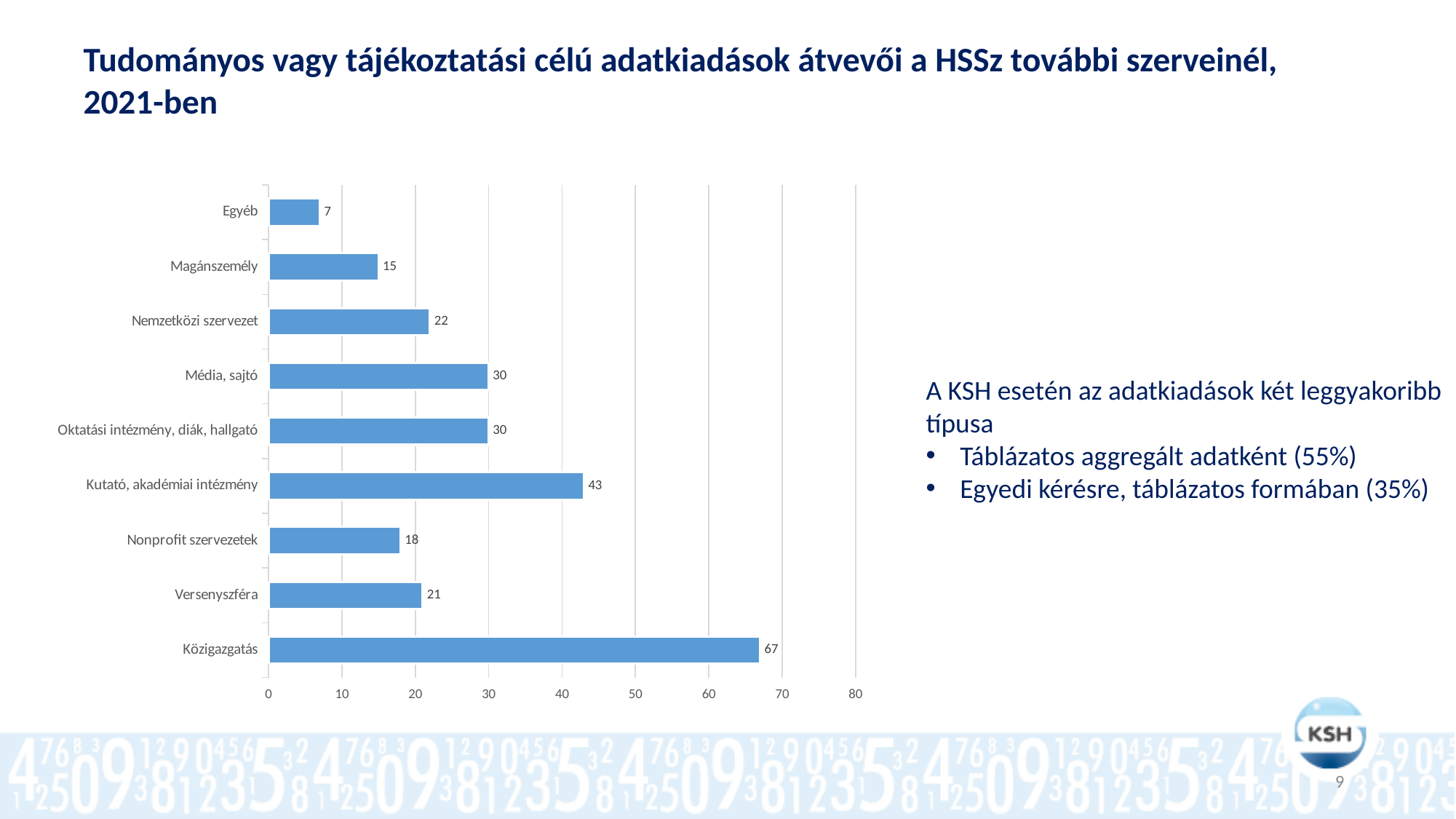
Which category has the highest value? Közigazgatás What is the value for Média, sajtó? 30 Which category has the lowest value? Egyéb What is the difference between the values for Közigazgatás and Kutató, akadémiai intézmény? 24 Which is larger, the value for Versenyszféra or the value for Nonprofit szervezetek? Versenyszféra Is the value for Nemzetközi szervezet greater or less than 30? less What is the value for Kutató, akadémiai intézmény? 43 What is the value for Magánszemély? 15 How many categories are shown in the chart? 9 What is the highest value shown on the x axis? 80 What kind of chart is shown on the slide? bar chart What is the value for Közigazgatás? 67